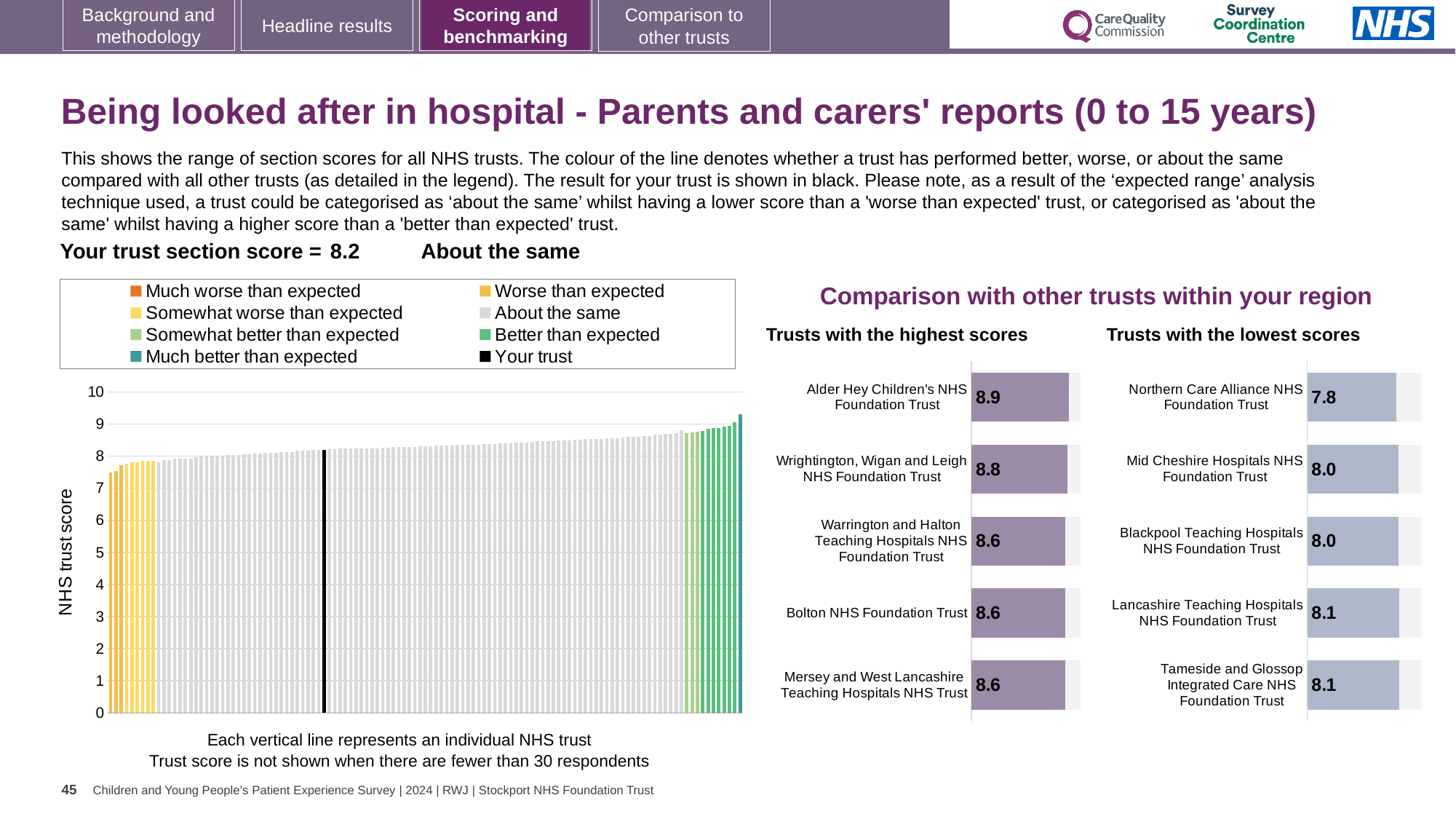
In the 'Trusts with the highest scores' chart, which trust has the highest score? Alder Hey Children's NHS Foundation Trust In the main chart of all NHS trusts on the left, what kind of chart is it? Bar chart In the 'Trusts with the highest scores' chart, how many trusts are shown? 5 In the 'Trusts with the lowest scores' chart, which has the larger score: Northern Care Alliance NHS Foundation Trust or Lancashire Teaching Hospitals NHS Foundation Trust? Lancashire Teaching Hospitals NHS Foundation Trust In the 'Trusts with the lowest scores' chart, which trust has the lowest score? Northern Care Alliance NHS Foundation Trust In the 'Trusts with the highest scores' chart, what is the score for Wrightington, Wigan and Leigh NHS Foundation Trust? 8.8 In the 'Trusts with the highest scores' chart, what is the score for Alder Hey Children's NHS Foundation Trust? 8.9 In the 'Trusts with the lowest scores' chart, what is the score for Northern Care Alliance NHS Foundation Trust? 7.8 In the 'Trusts with the lowest scores' chart, what is the difference between the scores of Tameside and Glossop Integrated Care NHS Foundation Trust and Northern Care Alliance NHS Foundation Trust? 0.3 In the main chart of all NHS trusts on the left, how many entries does the legend list? 8 In the 'Trusts with the highest scores' chart, what is the difference between the scores of Alder Hey Children's NHS Foundation Trust and Wrightington, Wigan and Leigh NHS Foundation Trust? 0.1 In the main chart of all NHS trusts on the left, do the trust scores rise or fall from left to right along the x axis? Rise